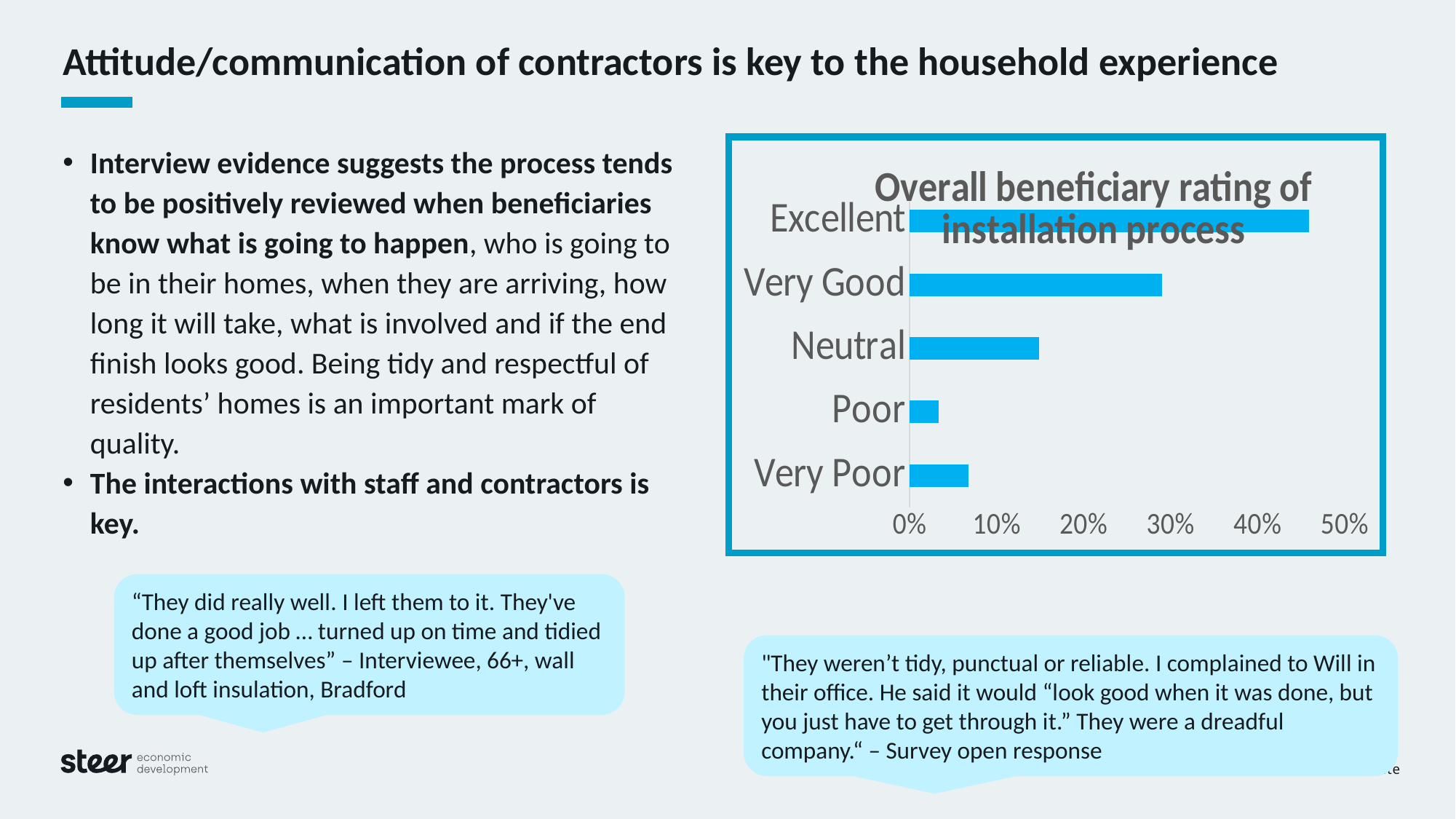
Which rating category has the lowest value? Poor Which is larger, the value for Poor or the value for Very Poor? Very Poor What type of chart is shown on the slide? Bar chart Which is larger, the value for Very Good or the value for Neutral? Very Good Is the value for Very Good greater or less than 20%? greater How many rating categories are shown in the chart? 5 Is the value for Excellent greater or less than 40%? greater Is the value for Neutral greater or less than 10%? greater What is the title of the chart? Overall beneficiary rating of installation process Which rating category has the highest value? Excellent